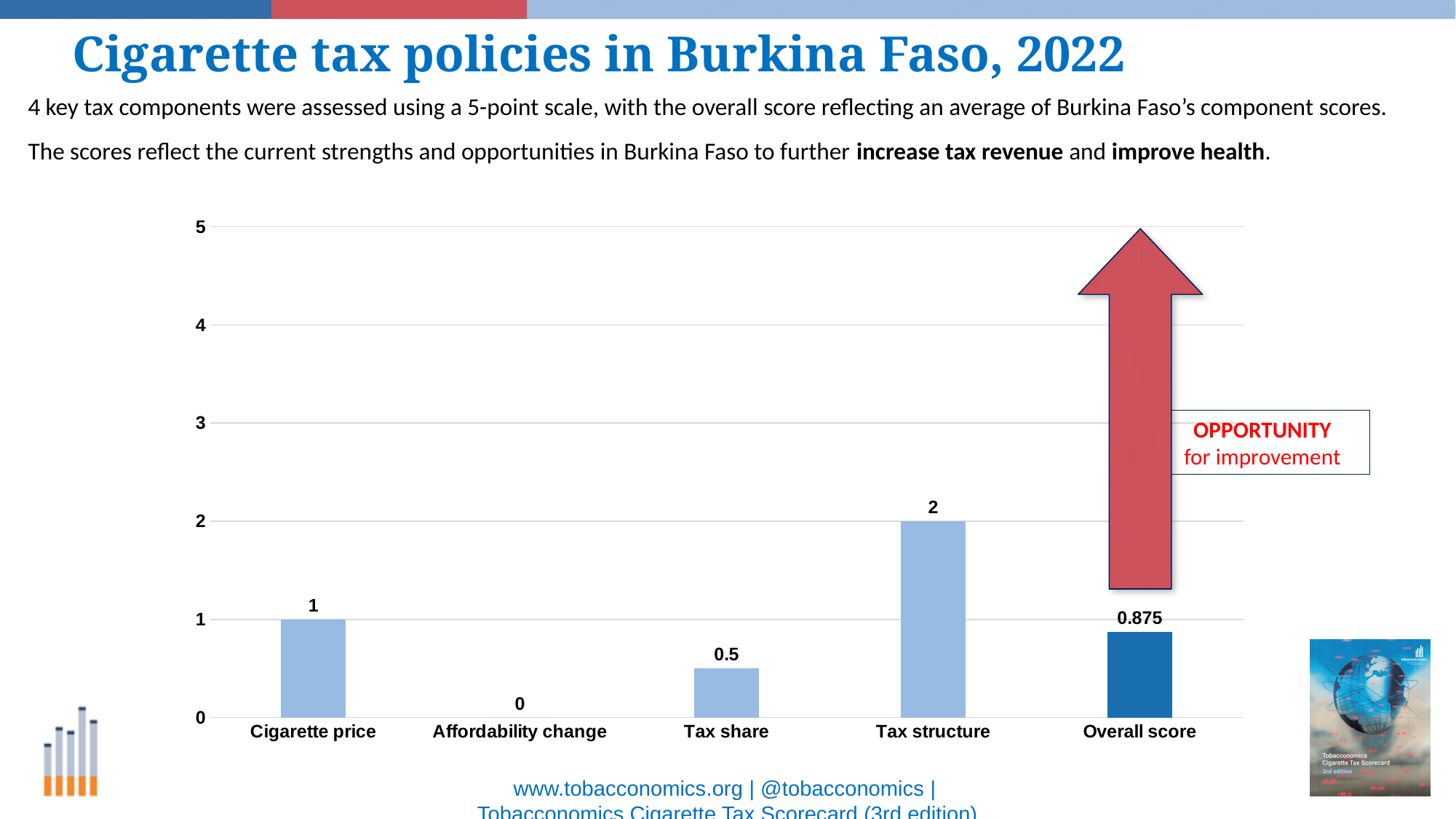
What is the Overall score? 0.875 What is the value for Tax structure? 2 Which category has the highest value? Tax structure Which category has the lowest value? Affordability change What is the value for Affordability change? 0 How many categories are shown on the x axis? 5 What is the value for Tax share? 0.5 Which is larger, the value for Cigarette price or the value for Tax share? Cigarette price What is the value for Cigarette price? 1 What is the maximum value shown on the y axis? 5 What kind of chart is shown on the slide? Bar chart What is the difference between the values for Tax structure and Cigarette price? 1